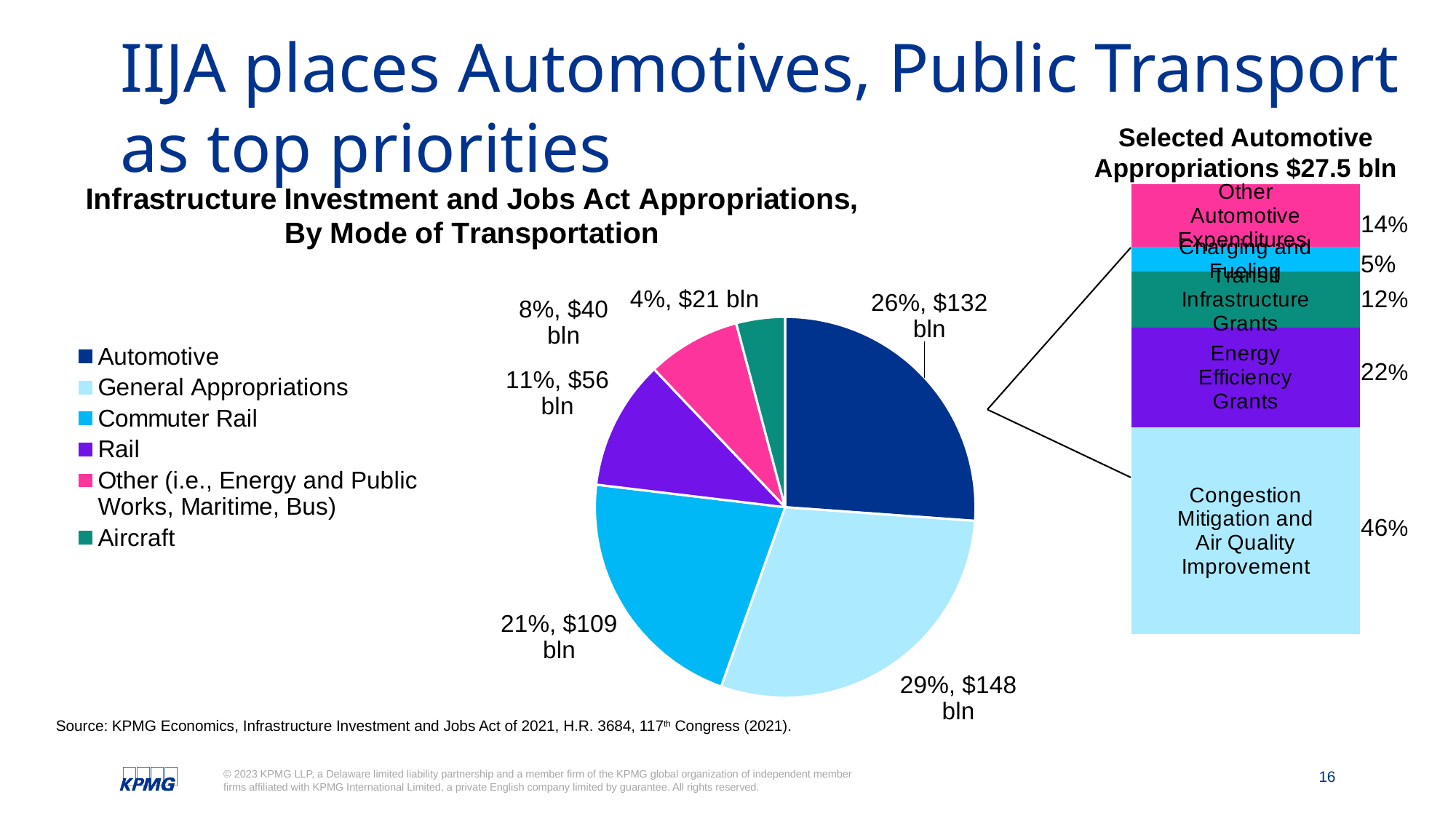
In the pie chart 'Infrastructure Investment and Jobs Act Appropriations, By Mode of Transportation', what is the difference in dollars between General Appropriations and Automotive? $16 bln In the pie chart 'Infrastructure Investment and Jobs Act Appropriations, By Mode of Transportation', which category has the smallest slice? Aircraft In the pie chart 'Infrastructure Investment and Jobs Act Appropriations, By Mode of Transportation', which is larger, Commuter Rail or Rail? Commuter Rail In the stacked bar 'Selected Automotive Appropriations $27.5 bln', which segment is the smallest? Charging and Fueling In the stacked bar 'Selected Automotive Appropriations $27.5 bln', what percentage is Energy Efficiency Grants? 22% In the pie chart 'Infrastructure Investment and Jobs Act Appropriations, By Mode of Transportation', what is the value for Automotive? $132 bln How many categories does the legend of the pie chart 'Infrastructure Investment and Jobs Act Appropriations, By Mode of Transportation' list? 6 In the pie chart 'Infrastructure Investment and Jobs Act Appropriations, By Mode of Transportation', what share of the pie is General Appropriations? 29% In the pie chart 'Infrastructure Investment and Jobs Act Appropriations, By Mode of Transportation', which category has the largest slice? General Appropriations In the stacked bar 'Selected Automotive Appropriations $27.5 bln', what percentage is Congestion Mitigation and Air Quality Improvement? 46% What kind of chart is 'Infrastructure Investment and Jobs Act Appropriations, By Mode of Transportation'? Pie chart In the pie chart 'Infrastructure Investment and Jobs Act Appropriations, By Mode of Transportation', what is the value for Aircraft? $21 bln